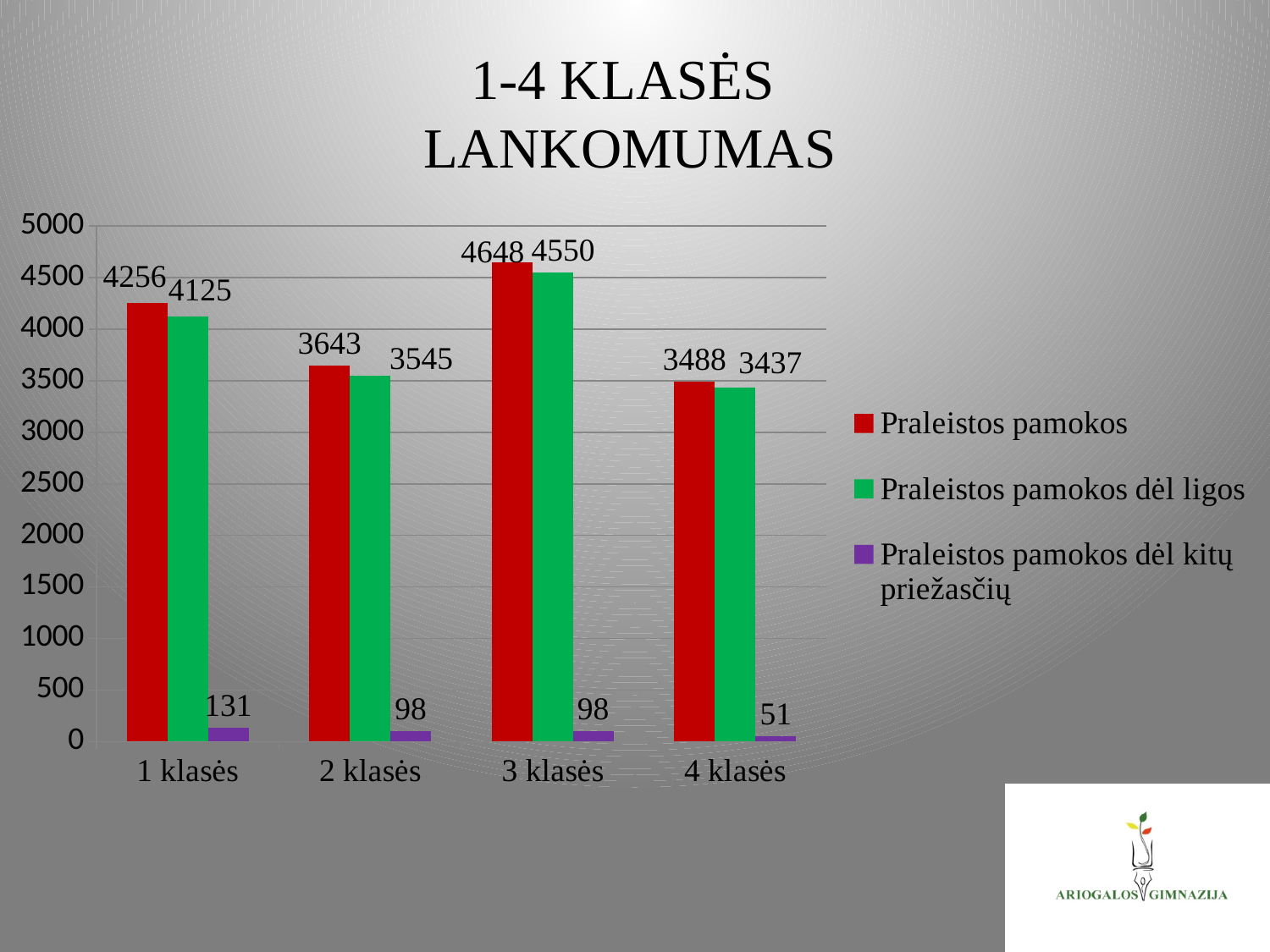
Which is larger: Praleistos pamokos dėl kitų priežasčių for 1 klasės or for 4 klasės? 1 klasės Is the value of Praleistos pamokos for 4 klasės greater or less than 3000? greater What kind of chart is shown on the slide? bar chart What is the value of Praleistos pamokos for 3 klasės? 4648 What is the difference between Praleistos pamokos and Praleistos pamokos dėl ligos for 2 klasės? 98 What is the value of Praleistos pamokos dėl ligos for 1 klasės? 4125 What is the title of the slide? 1-4 KLASĖS LANKOMUMAS Which class has the lowest value for Praleistos pamokos dėl ligos? 4 klasės How many series does the legend list? 3 How many classes are shown on the x axis? 4 What is the value of Praleistos pamokos dėl kitų priežasčių for 4 klasės? 51 Which class has the highest value for Praleistos pamokos? 3 klasės